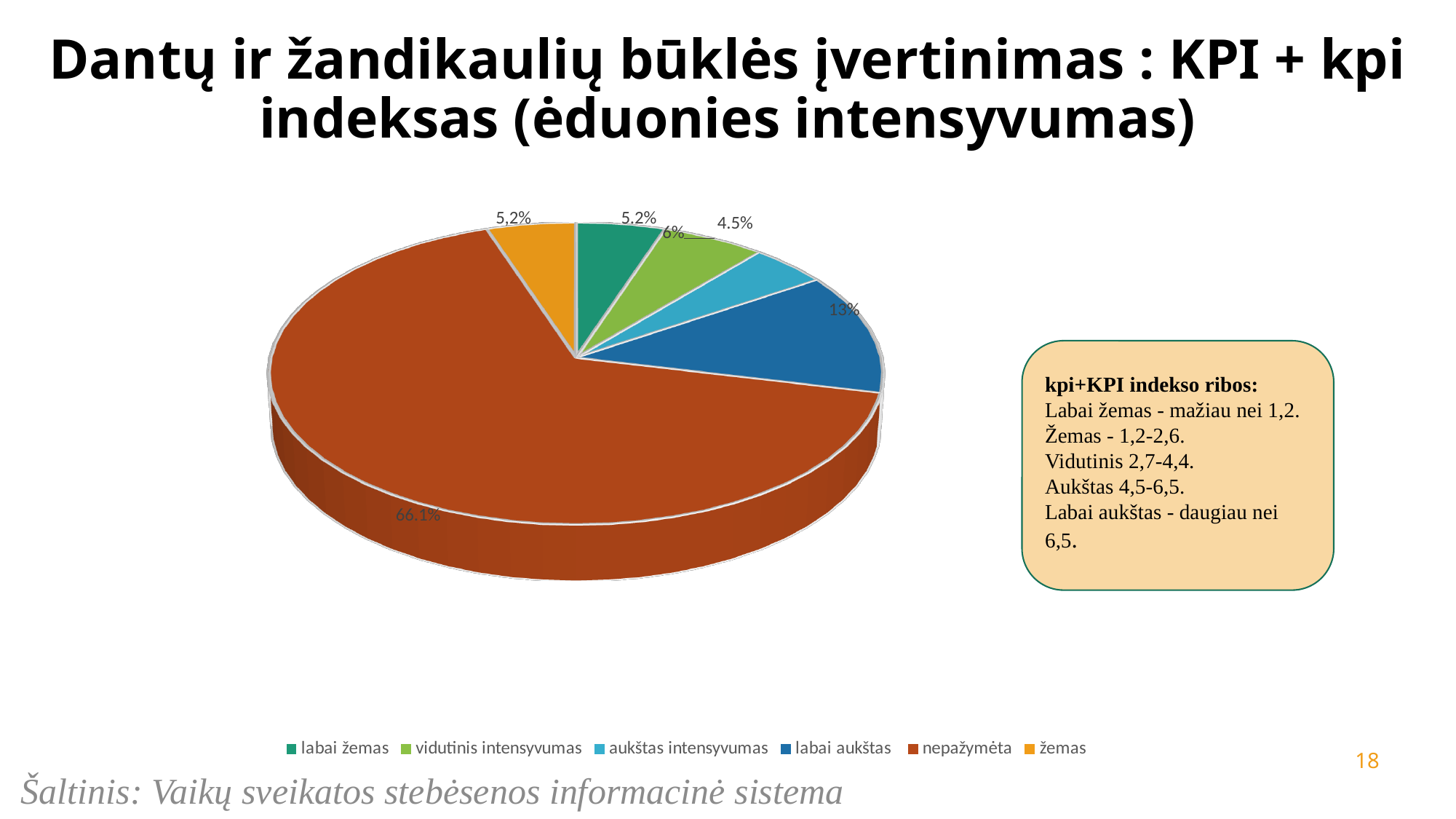
Which category has the largest slice of the pie? nepažymėta What colour is the 'nepažymėta' slice in the pie chart? brown Which slice is larger, 'labai aukštas' or 'vidutinis intensyvumas'? labai aukštas Which category has the smallest slice of the pie? aukštas intensyvumas What kind of chart is shown on the slide? pie chart How many categories does the legend of the pie chart list? 6 What is the difference in percentage points between the 'nepažymėta' slice and the 'labai aukštas' slice? 53.1 What share of the pie is labelled for the 'labai žemas' slice? 5.2% What share of the pie is labelled for the 'aukštas intensyvumas' slice? 4.5% What share of the pie is labelled for the 'vidutinis intensyvumas' slice? 6% What share of the pie is labelled for the 'labai aukštas' slice? 13% What share of the pie is labelled for the 'nepažymėta' slice? 66.1%